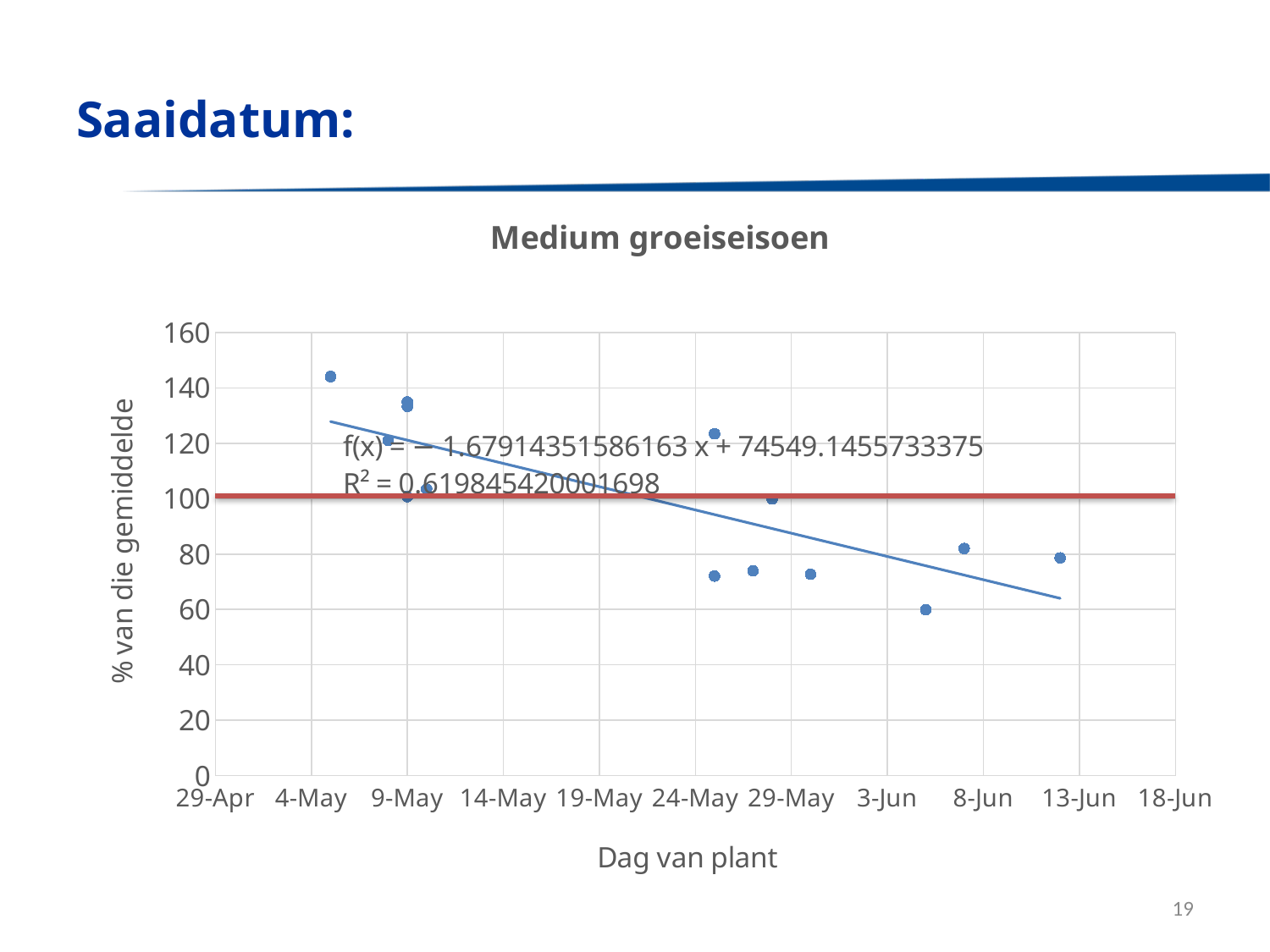
At which y-axis value is the red horizontal line drawn? 100 Is the value of the lowest point plotted near 5-Jun greater or less than 80? less Is the value of the point plotted nearest 13-Jun greater or less than 100? less Is the value of the point plotted nearest 4-May greater or less than 120? greater Do the plotted values generally rise or fall as the planting date moves from left to right along the x axis? fall What is the title of the chart? Medium groeiseisoen Which plotted point has the higher value: the one nearest 4-May or the one nearest 13-Jun? the one nearest 4-May What kind of chart is shown on the slide? scatter chart Which plotted point has the lower value: the one nearest 5-Jun or the one nearest 8-Jun? the one nearest 5-Jun